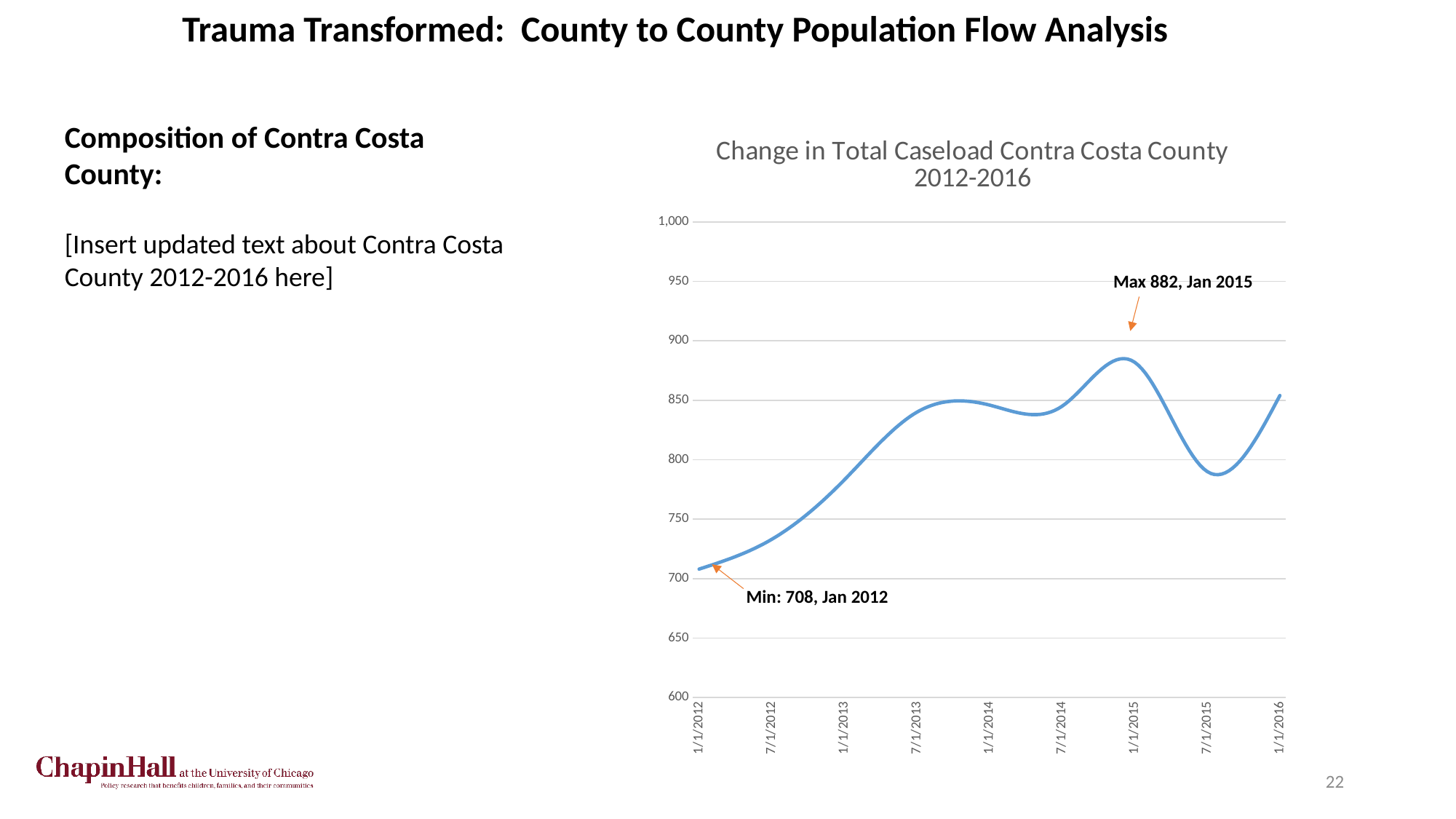
What is the minimum caseload value annotated on the chart? 708 What is the maximum caseload value annotated on the chart? 882 What is the difference between the maximum (882) and minimum (708) caseload values? 174 Is the caseload value at 7/1/2012 greater or less than 750? less What is the title of the chart? Change in Total Caseload Contra Costa County 2012-2016 In which month does the caseload reach its minimum? Jan 2012 Is the caseload value at 7/1/2015 greater or less than 800? less Is the caseload value at 7/1/2013 greater or less than 800? greater Does the caseload rise or fall between Jan 2015 and Jul 2015? fall What kind of chart is shown on the slide? line chart Which is larger, the caseload at 1/1/2016 or at 7/1/2015? 1/1/2016 In which month does the caseload reach its maximum? Jan 2015